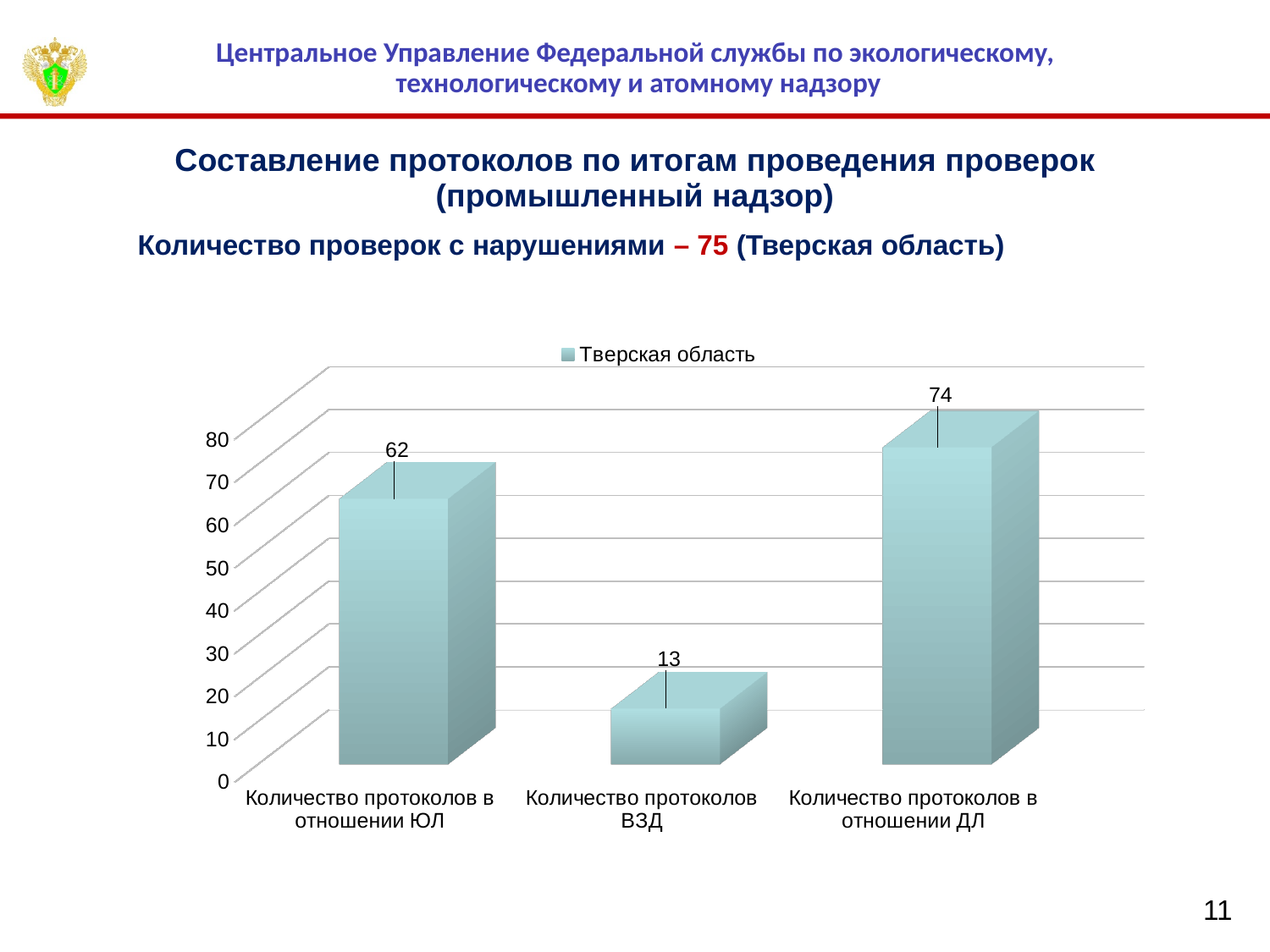
What is the value for "Количество протоколов в отношении ЮЛ"? 62 Which category has the lowest value? Количество протоколов ВЗД What is the difference between the values for "Количество протоколов в отношении ЮЛ" and "Количество протоколов ВЗД"? 49 What kind of chart is shown on the slide? bar chart What is the value for "Количество протоколов ВЗД"? 13 How many categories are shown on the chart? 3 What is the value for "Количество протоколов в отношении ДЛ"? 74 Is the value for "Количество протоколов ВЗД" greater or less than 20? less How many series does the legend list? 1 Which is larger: the value for "Количество протоколов в отношении ЮЛ" or for "Количество протоколов ВЗД"? Количество протоколов в отношении ЮЛ What is the difference between the values for "Количество протоколов в отношении ДЛ" and "Количество протоколов в отношении ЮЛ"? 12 Which category has the highest value? Количество протоколов в отношении ДЛ